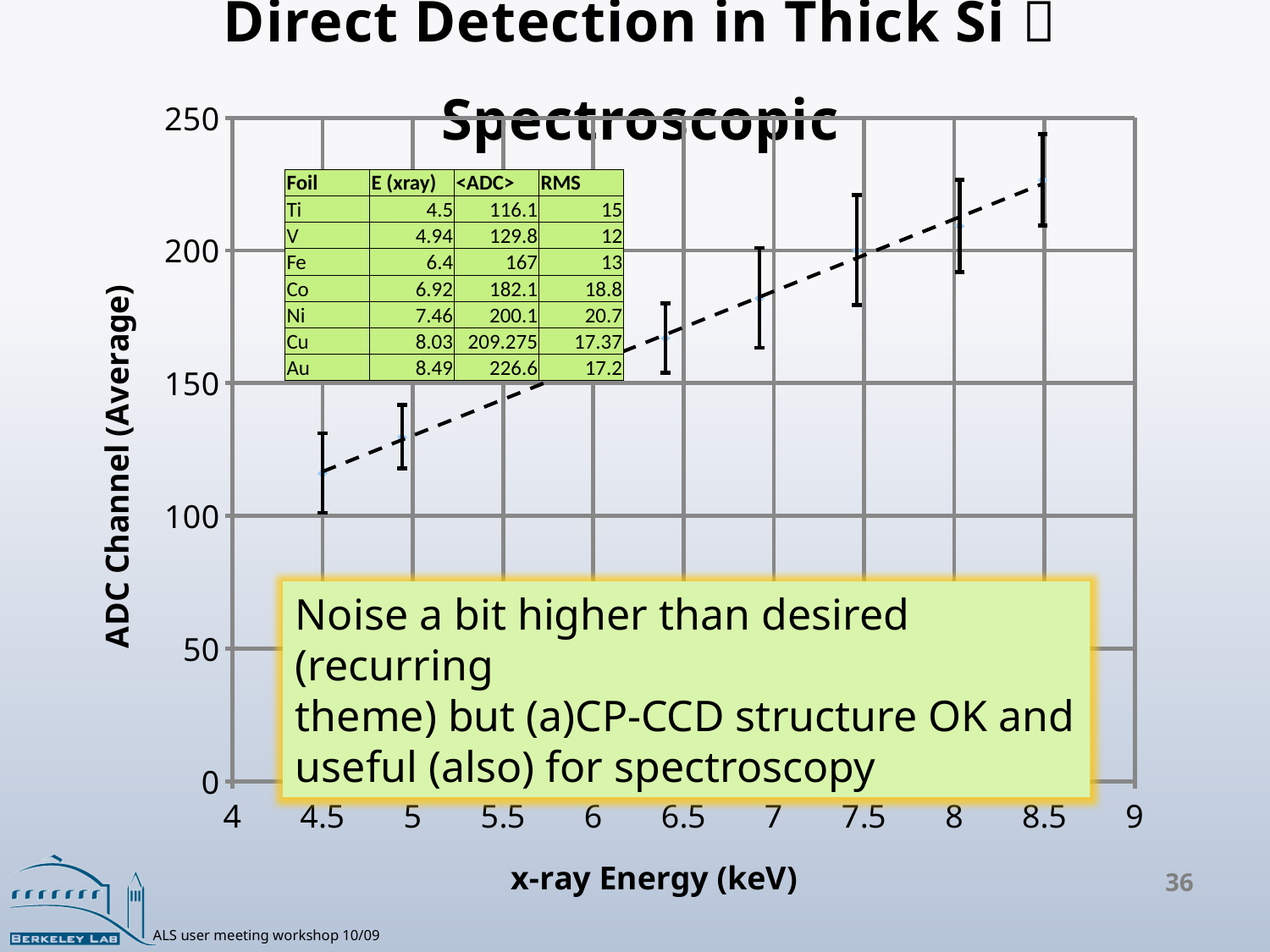
How many data points are plotted on the chart? 7 What is the title of the y axis of the chart? ADC Channel (Average) Do the ADC channel values rise or fall as x-ray energy increases along the x axis? rise According to the table on the chart, what is the <ADC> value for the Ti foil? 116.1 Which foil has the lowest <ADC> value in the table on the chart? Ti According to the table on the chart, what is the <ADC> value for the Cu foil? 209.275 What is the difference between the <ADC> values for Au and Ti in the table on the chart? 110.5 What is the title of the x axis of the chart? x-ray Energy (keV) According to the table on the chart, what is the RMS value for the Ni foil? 20.7 Which foil has the highest <ADC> value in the table on the chart? Au Is the plotted ADC channel value at 8.5 keV greater or less than 200? greater Which has a larger <ADC> value in the table on the chart, Fe or Co? Co